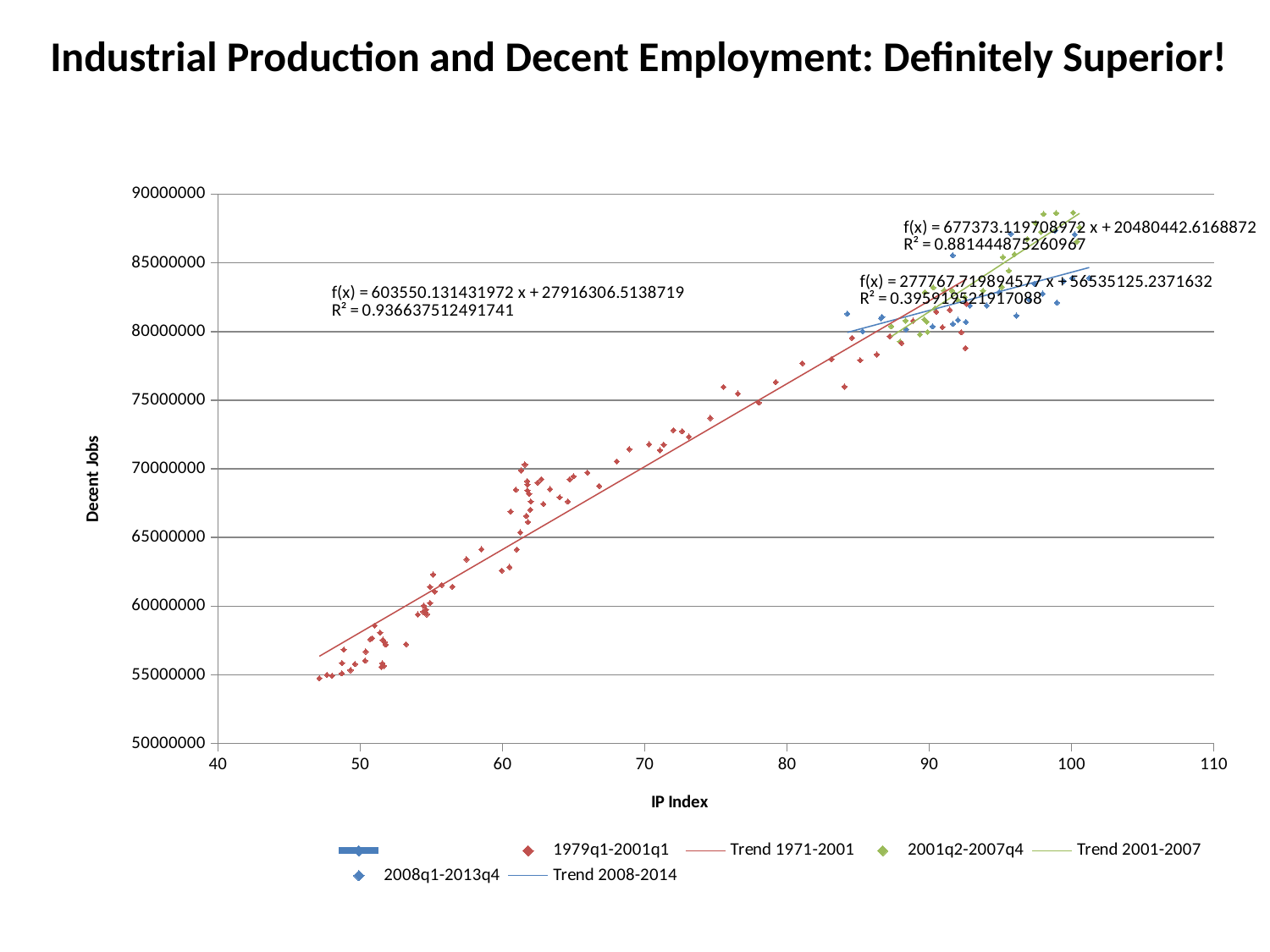
What is the title of the chart? Industrial Production and Decent Employment: Definitely Superior! Do the Decent Jobs values generally rise or fall as the IP Index increases? rise Which of the three R² values printed on the chart is the lowest? 0.395919521917088 How many trend lines does the legend list? 3 Are the Decent Jobs values for the 1979q1-2001q1 points near an IP Index of 50 greater or less than 60000000? less What kind of chart is shown on the slide? scatter chart What is the R² value shown for the trend line with equation f(x) = 603550.131431972 x + 27916306.5138719? 0.936637512491741 What is the R² value shown for the trend line with equation f(x) = 277767.719894577 x + 56535125.2371632? 0.395919521917088 What is the label of the x axis? IP Index What is the R² value shown for the trend line with equation f(x) = 677373.119708972 x + 20480442.6168872? 0.881444875260967 Which of the three R² values printed on the chart is the highest? 0.936637512491741